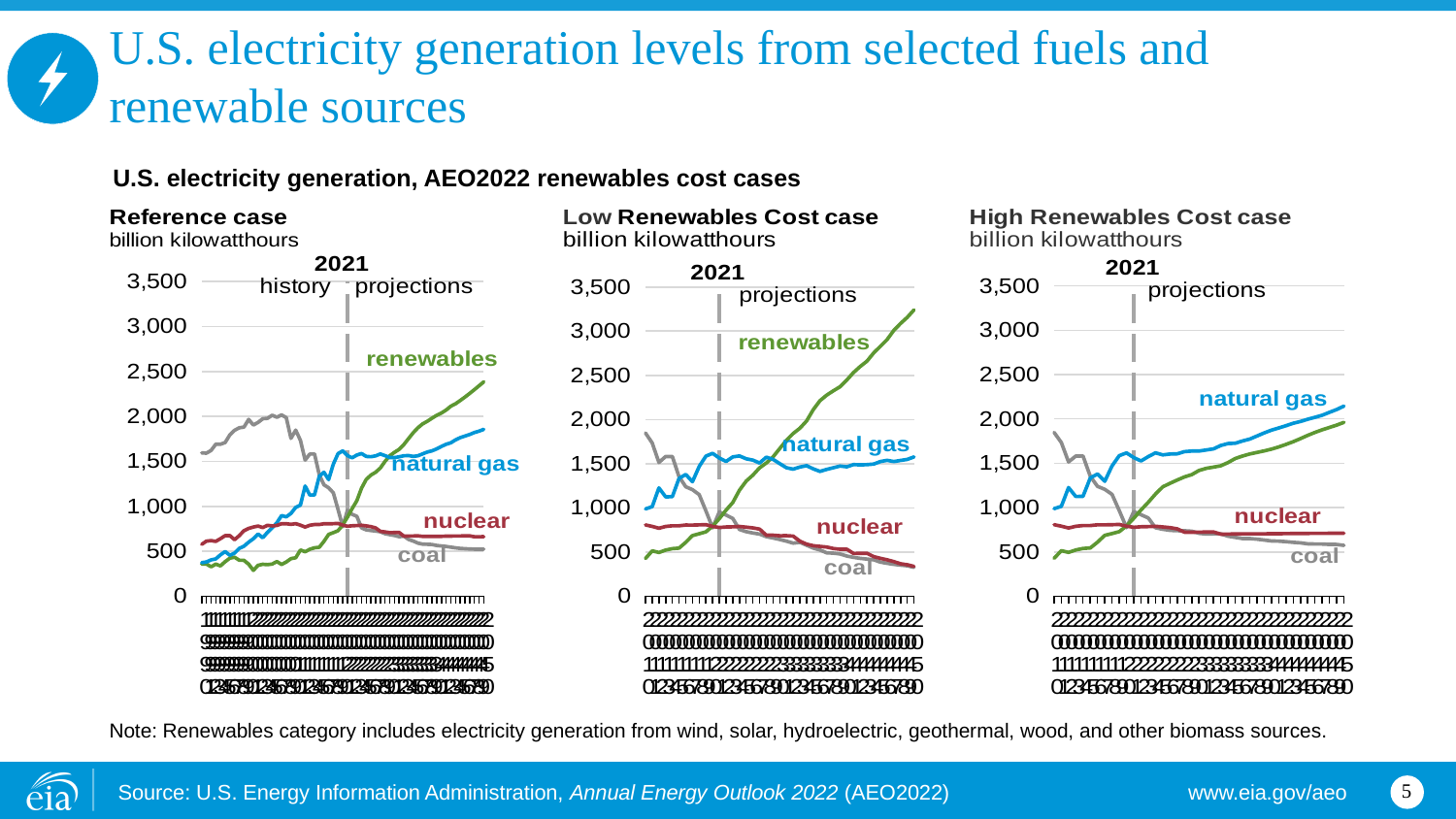
In the High Renewables Cost case chart, is the value for natural gas at the end of the projection period greater or less than 2,500? less In the Low Renewables Cost case chart, is the value for renewables at the end of the projection period greater or less than 3,000? greater What unit is used on the y axis of the three charts? billion kilowatthours In the Low Renewables Cost case chart, does the renewables line rise or fall over the projection period? rise In the High Renewables Cost case chart, is the value for nuclear at the end of the projection period greater or less than 500? greater In the Reference case chart, which fuel has the highest generation at the end of the projection period? renewables What kind of chart is the Reference case chart? line chart In the High Renewables Cost case chart, does the coal line rise or fall over the projection period? fall In the Reference case chart, which fuel has the lowest generation at the end of the projection period? coal How many fuel series are plotted in the Low Renewables Cost case chart? 4